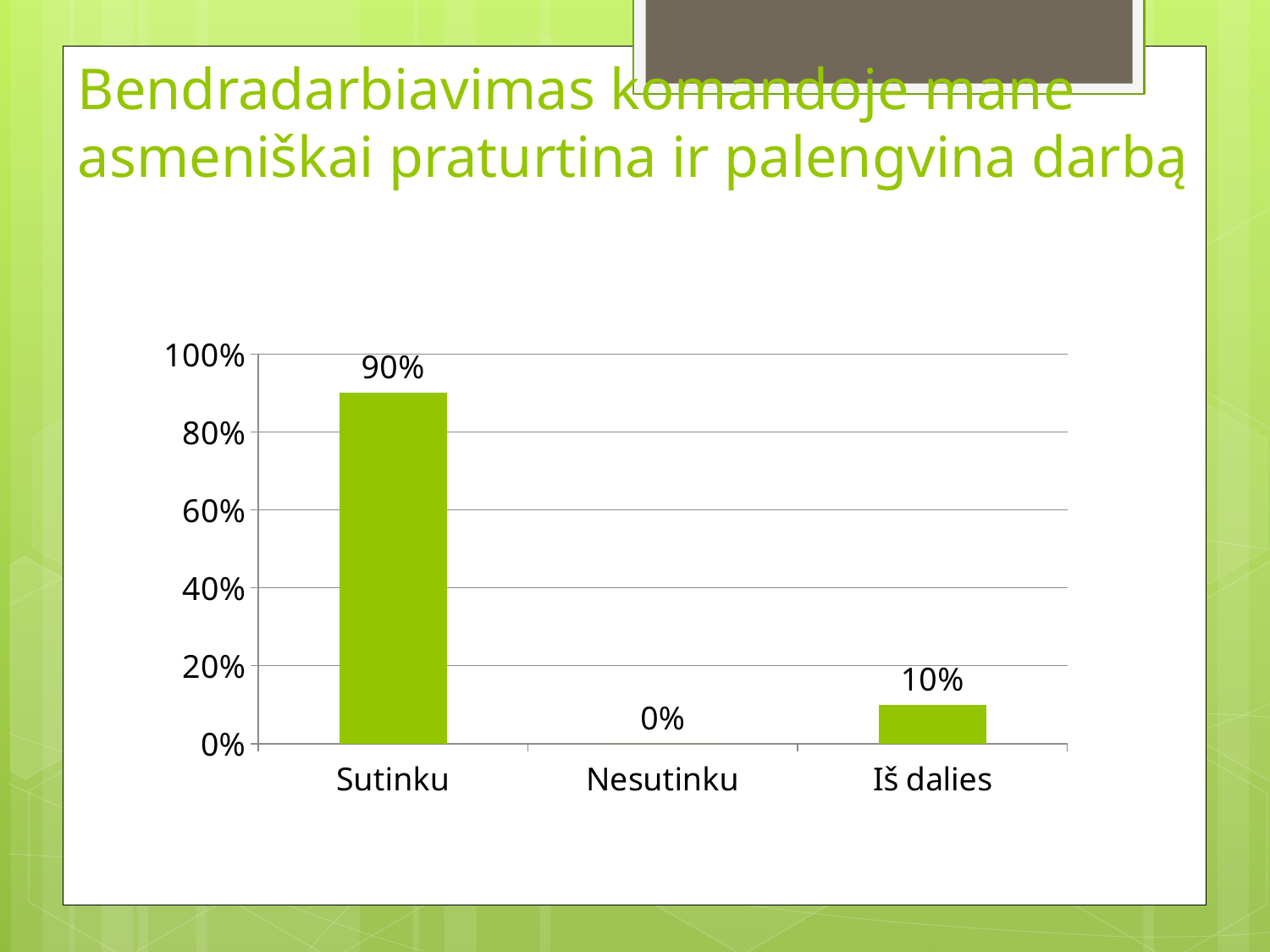
How many categories are shown on the x axis? 3 What is the highest value shown on the y axis? 100% Is the value for Iš dalies greater or less than 20%? less Which is larger, the value for Iš dalies or the value for Nesutinku? Iš dalies What is the difference between the values for Sutinku and Iš dalies? 80% Which category has the highest value? Sutinku What is the value for Iš dalies? 10% Is the value for Sutinku greater or less than 80%? greater Which category has the lowest value? Nesutinku What kind of chart is shown on the slide? bar chart What is the value for Sutinku? 90% What is the value for Nesutinku? 0%